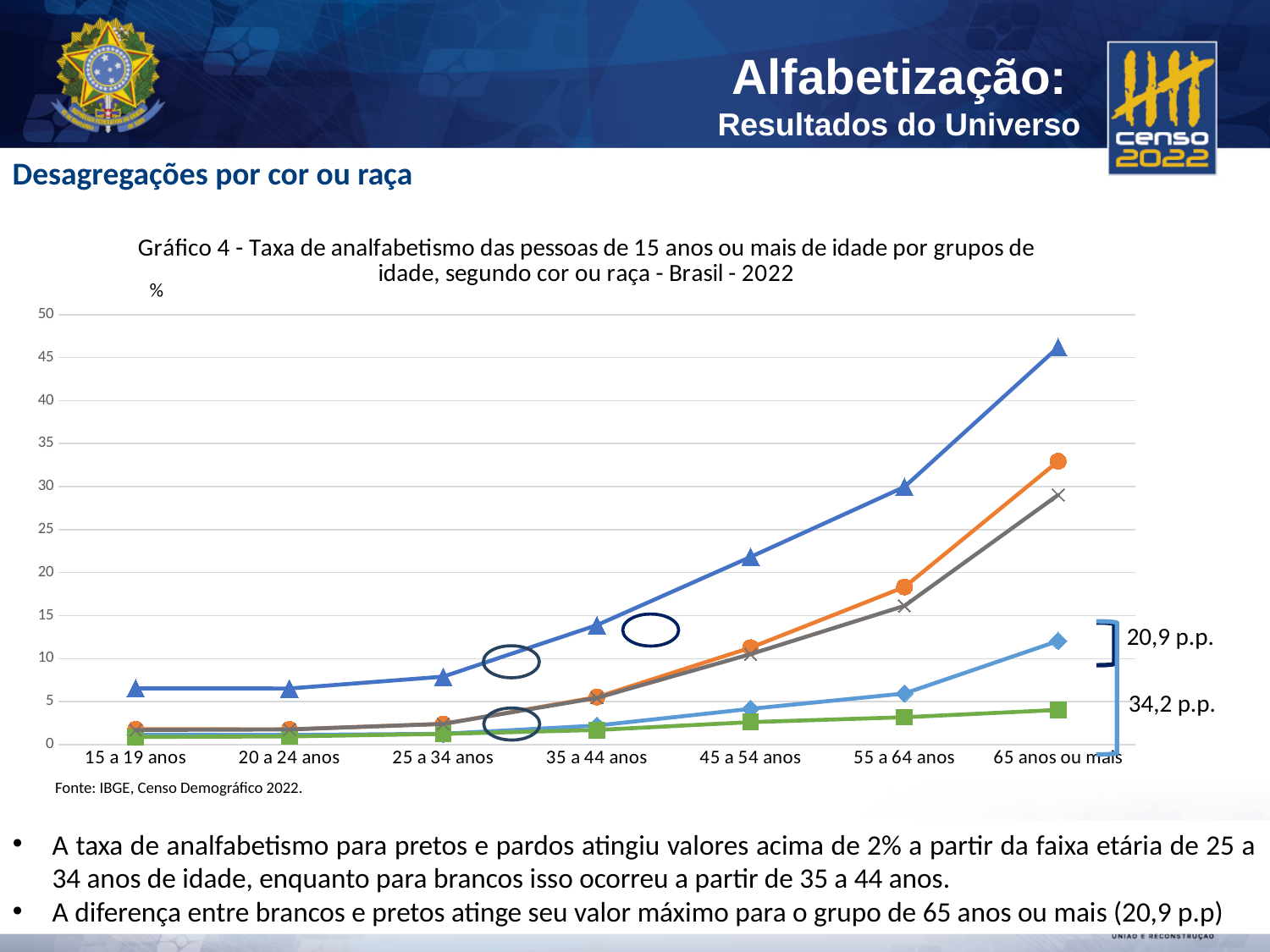
At '65 anos ou mais', which line has the higher value: the orange circle-marker line or the grey x-marker line? the orange circle-marker line Is the value of the green square-marker line for '65 anos ou mais' greater or less than 5? less How many lines (series) are plotted on the chart? 5 Is the value of the orange circle-marker line for '65 anos ou mais' greater or less than 30? greater What difference in percentage points is annotated at the top right of the chart, next to the bracket between the two upper lines? 20,9 p.p. Do the values of the dark blue triangle-marker line rise or fall from '15 a 19 anos' to '65 anos ou mais'? rise Is the value of the dark blue triangle-marker line for '45 a 54 anos' greater or less than 20? greater What unit is indicated on the vertical axis of the chart? % How many age groups are shown on the x axis of the chart? 7 What kind of chart is shown on the slide? line chart Which age group has the highest value for the dark blue triangle-marker line? 65 anos ou mais